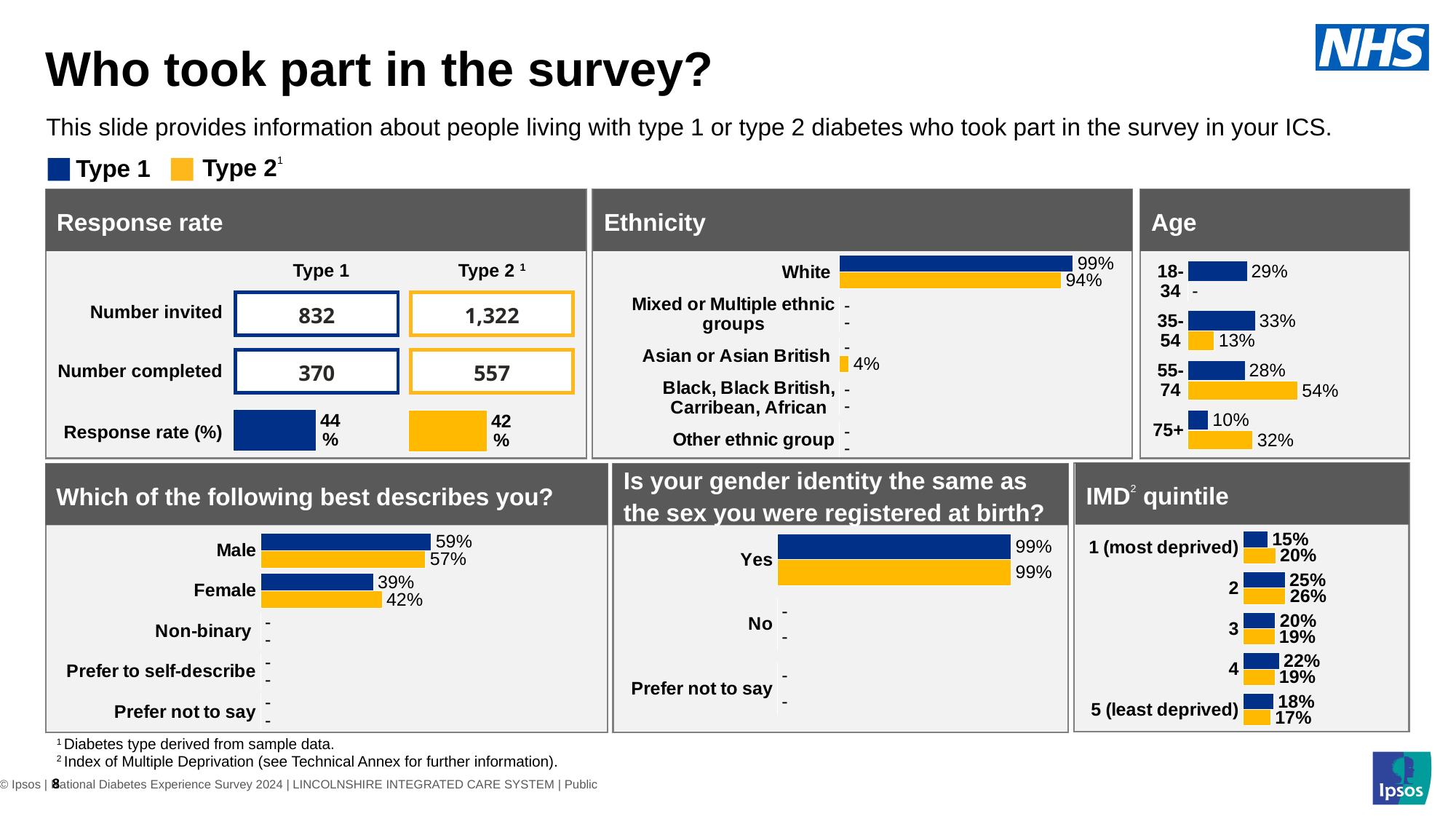
In the Response rate chart, what is the response rate for Type 1? 44% In the Age chart, what is the Type 1 value for 75+? 10% In the IMD quintile chart, what is the difference between the Type 1 and Type 2 values for quintile 1 (most deprived)? 5 percentage points In the 'Which of the following best describes you?' chart, how many categories are listed? 5 In the IMD quintile chart, which quintile has the highest Type 1 value? 2 In the Age chart, which is larger for the 35-54 group, the Type 1 value or the Type 2 value? Type 1 In the Age chart, which age group has the highest Type 2 value? 55-74 In the Response rate chart, what is the number completed for Type 2? 557 In the 'Which of the following best describes you?' chart, what is the Type 2 value for Female? 42% In the Ethnicity chart, what is the difference between the Type 1 and Type 2 values for White? 5 percentage points In the Ethnicity chart, what percentage of Type 2 respondents are White? 94% In the gender identity chart, what is the Type 1 value for Yes? 99%